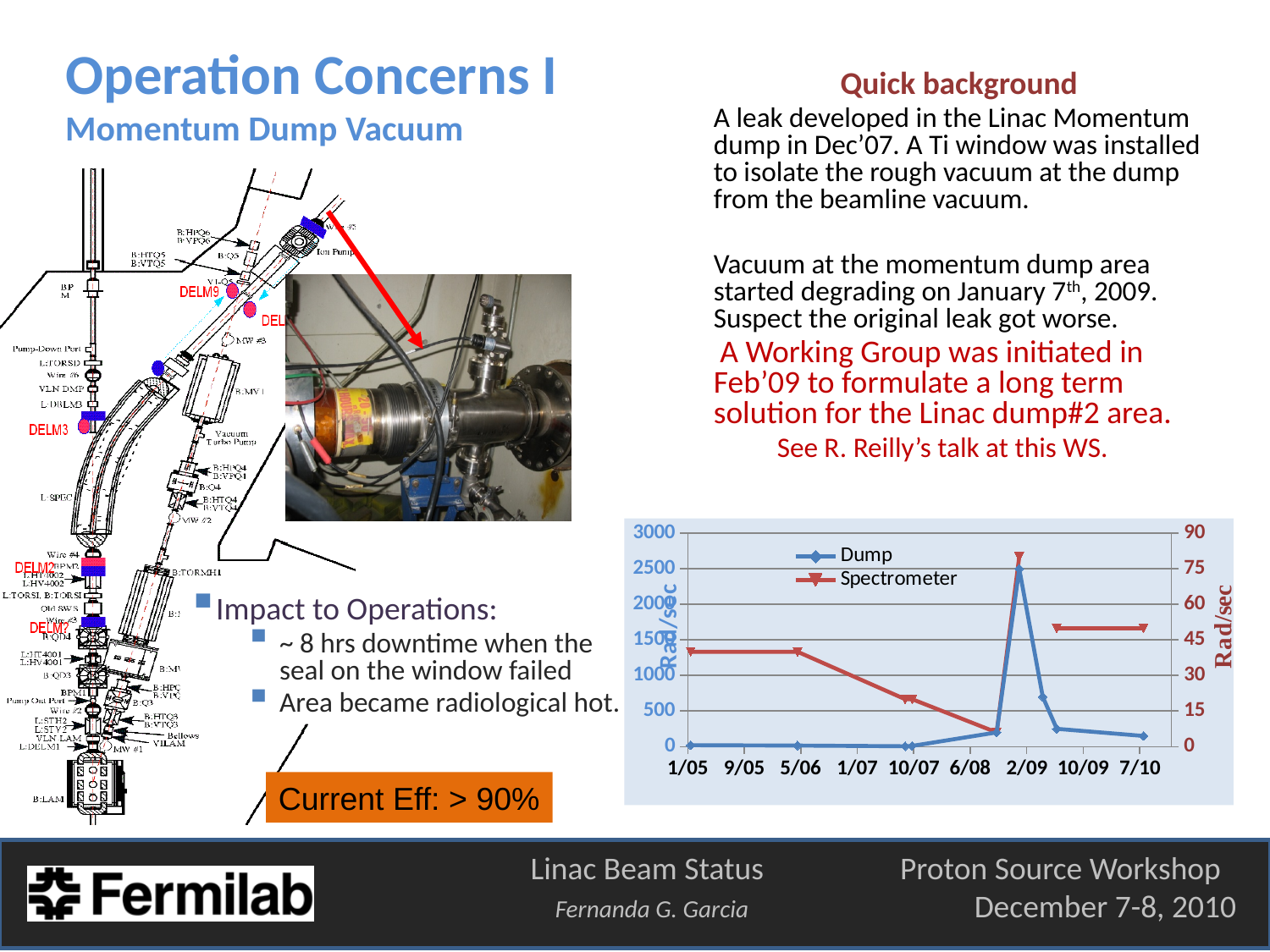
Is the Spectrometer value at 10/07 greater or less than 30 on the right axis? less At which date does the Spectrometer series reach its highest value? 2/09 At which date does the Dump series reach its highest value? 2/09 What are the two series named in the chart legend? Dump and Spectrometer What kind of chart is shown on the slide? line chart Does the Dump series rise or fall between 2/09 and 7/10? fall How many series does the chart legend list? 2 Is the Dump value at 2/09 greater or less than 2000 on the left axis? greater Does the Spectrometer series rise or fall between 1/05 and 6/08? fall What is the maximum value shown on the right-hand vertical axis of the chart? 90 Is the Spectrometer value at 6/08 greater or less than 15 on the right axis? less